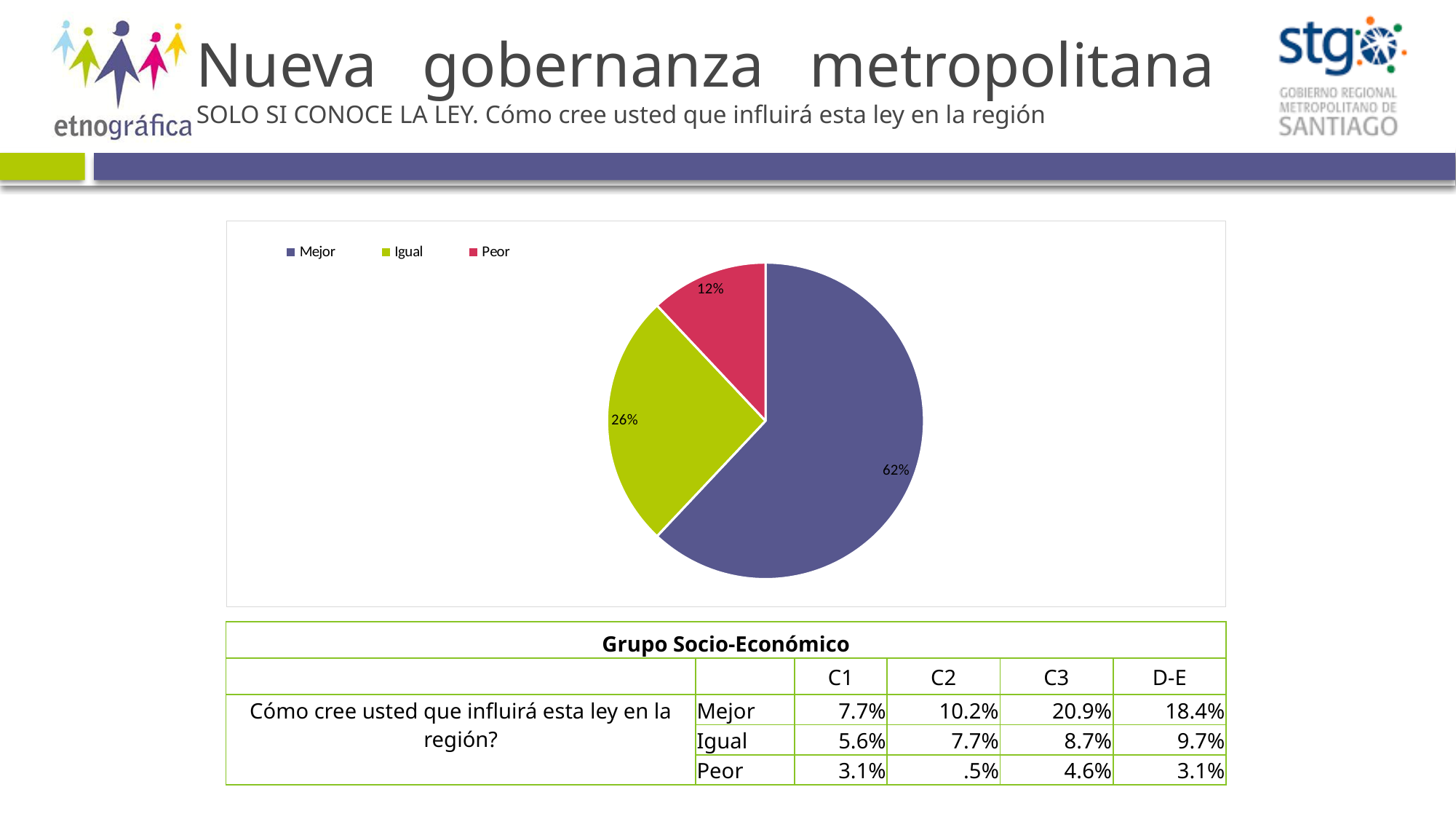
What percentage of the pie chart is labelled Igual? 26% How many slices does the pie chart have? 3 What kind of chart is shown on the slide? pie chart Which category has the largest slice in the pie chart? Mejor What colour is the Peor slice in the pie chart? red Which slice is larger, Igual or Peor? Igual How many entries does the legend of the pie chart list? 3 What is the difference in percentage points between the Mejor slice and the Igual slice? 36 Which category has the smallest slice in the pie chart? Peor What colour is the Igual slice in the pie chart? green What percentage of the pie chart is labelled Peor? 12% What percentage of the pie chart is labelled Mejor? 62%